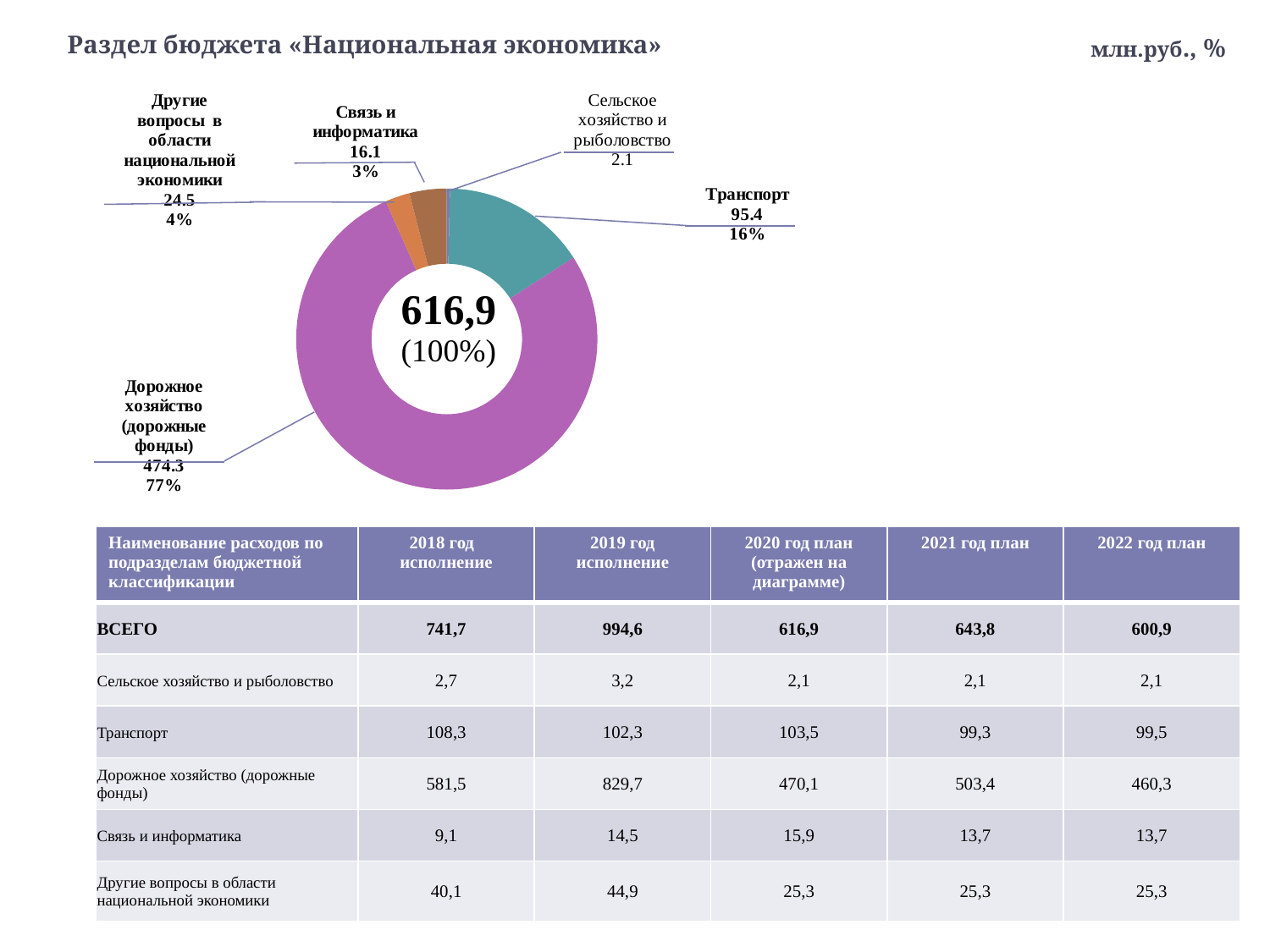
What share of the doughnut chart does Транспорт represent? 16% What value is shown for Транспорт on the doughnut chart? 95.4 How many categories are shown in the doughnut chart? 5 What value is shown for Дорожное хозяйство (дорожные фонды) on the doughnut chart? 474.3 Which category has the smallest slice in the doughnut chart? Сельское хозяйство и рыболовство Which category has the largest slice in the doughnut chart? Дорожное хозяйство (дорожные фонды) What value is shown for Сельское хозяйство и рыболовство on the doughnut chart? 2.1 What is the total value shown in the centre of the doughnut chart? 616,9 What share of the doughnut chart does Дорожное хозяйство (дорожные фонды) represent? 77% What kind of chart is shown on the slide? Doughnut (pie) chart What value is shown for Связь и информатика on the doughnut chart? 16.1 What is the difference between the values for Транспорт and Связь и информатика in the doughnut chart? 79.3